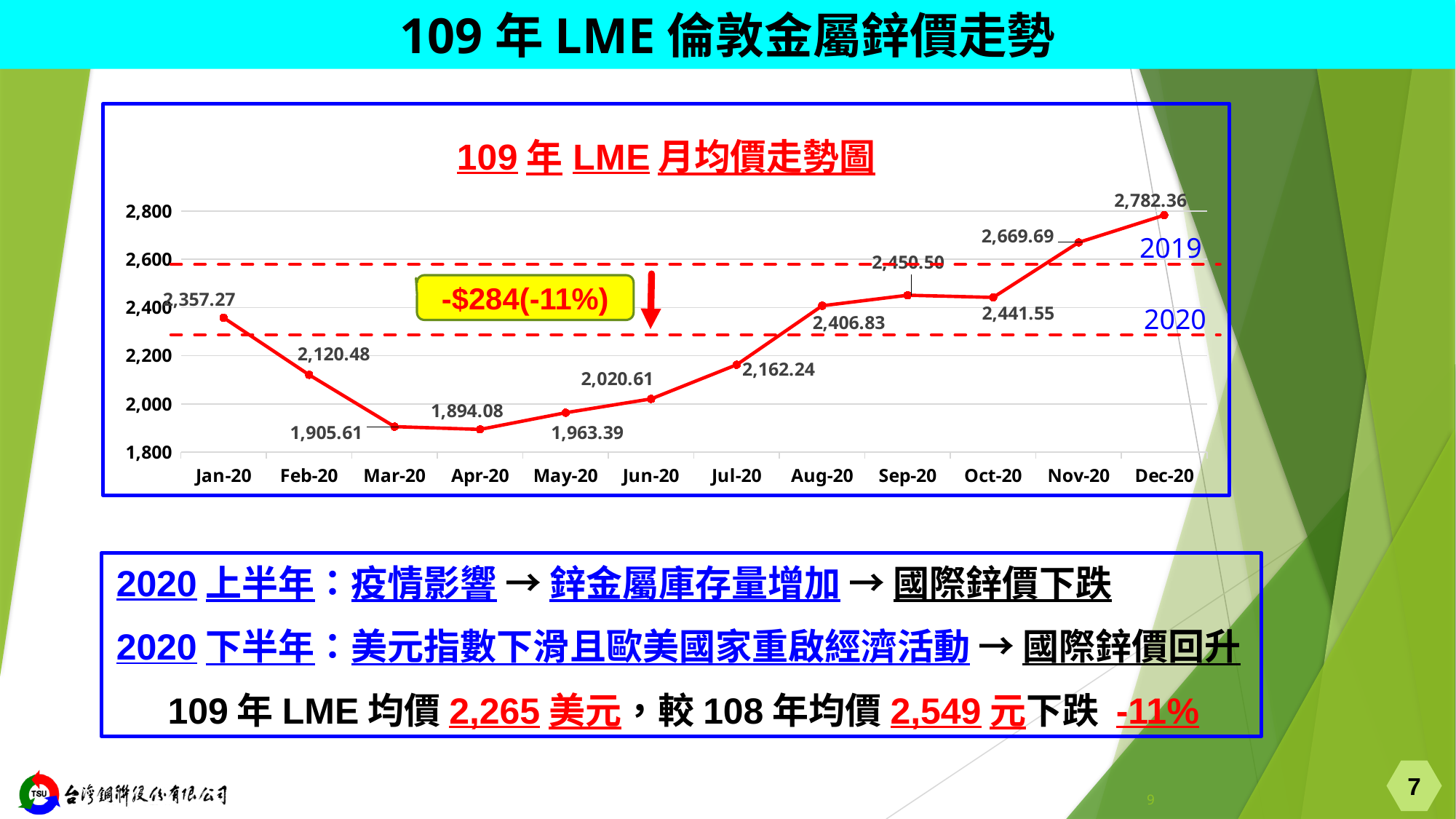
What is the LME monthly average price for Dec-20? 2,782.36 Which is larger, the monthly average price for Feb-20 or Jul-20? Jul-20 What is the LME monthly average price for Jan-20? 2,357.27 Does the monthly average price rise or fall from Apr-20 to Dec-20? rise Is the value for Nov-20 greater or less than 2,600? greater What is the LME monthly average price for Sep-20? 2,450.50 What is the LME monthly average price for Apr-20? 1,894.08 What type of chart is shown on the slide? line chart Which month has the highest monthly average price? Dec-20 What is the difference between the Dec-20 and Jan-20 monthly average prices? 425.09 Which month has the lowest monthly average price? Apr-20 How many months are plotted on the chart? 12